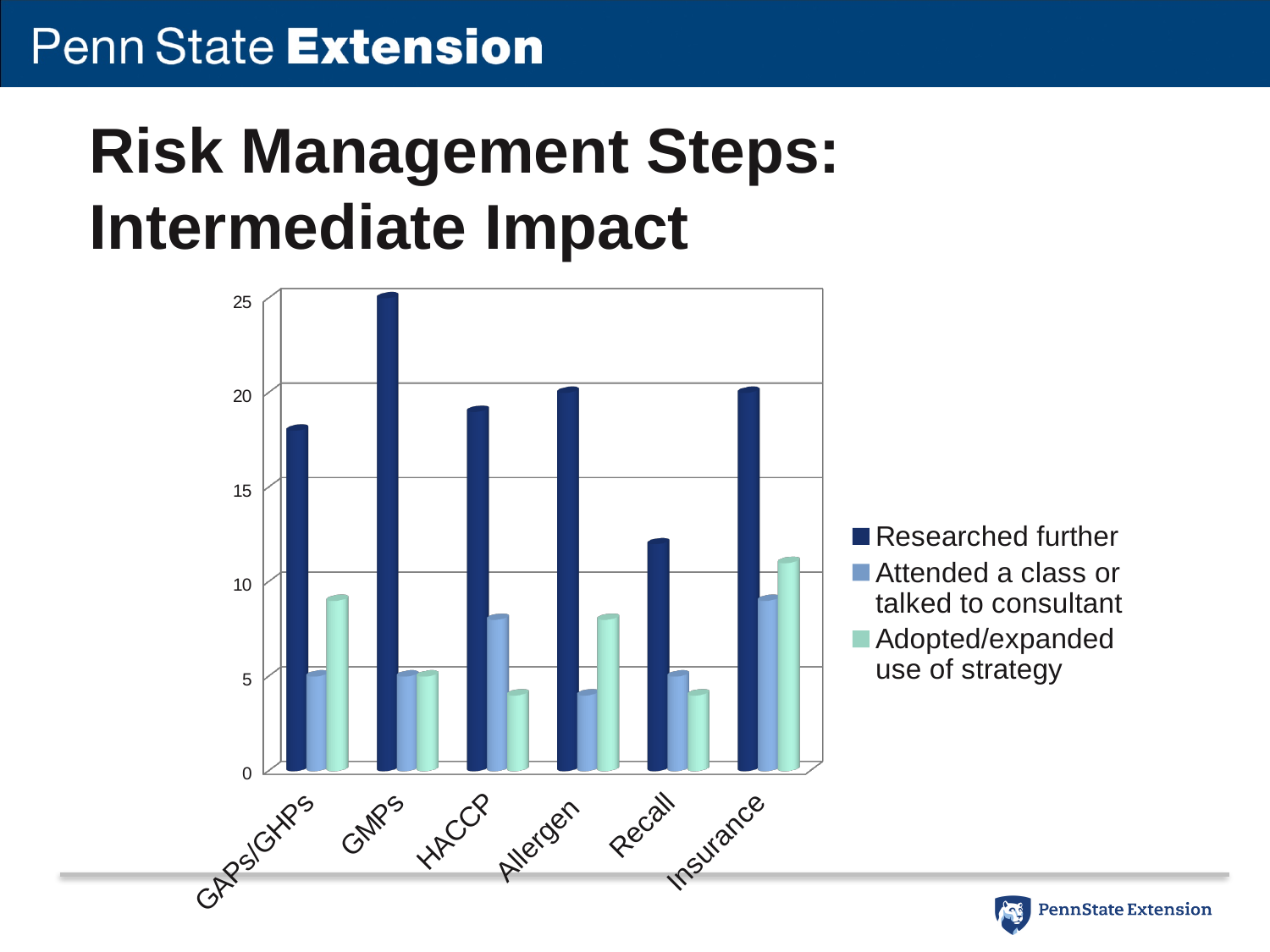
Is the Researched further value for GAPs/GHPs greater or less than 15? greater How many series does the legend list? 3 Is the Adopted/expanded use of strategy value for HACCP greater or less than 5? less For HACCP, which series has the larger value: Attended a class or talked to consultant, or Adopted/expanded use of strategy? Attended a class or talked to consultant Which category has the lowest value for Researched further? Recall Which has the larger Adopted/expanded use of strategy value, Insurance or Recall? Insurance What kind of chart is shown on the slide? bar chart How many categories are shown on the x axis? 6 Is the Researched further value for Recall greater or less than 10? greater What are the three series listed in the legend? Researched further; Attended a class or talked to consultant; Adopted/expanded use of strategy Which category has the highest value for Adopted/expanded use of strategy? Insurance Which category has the highest value for Researched further? GMPs